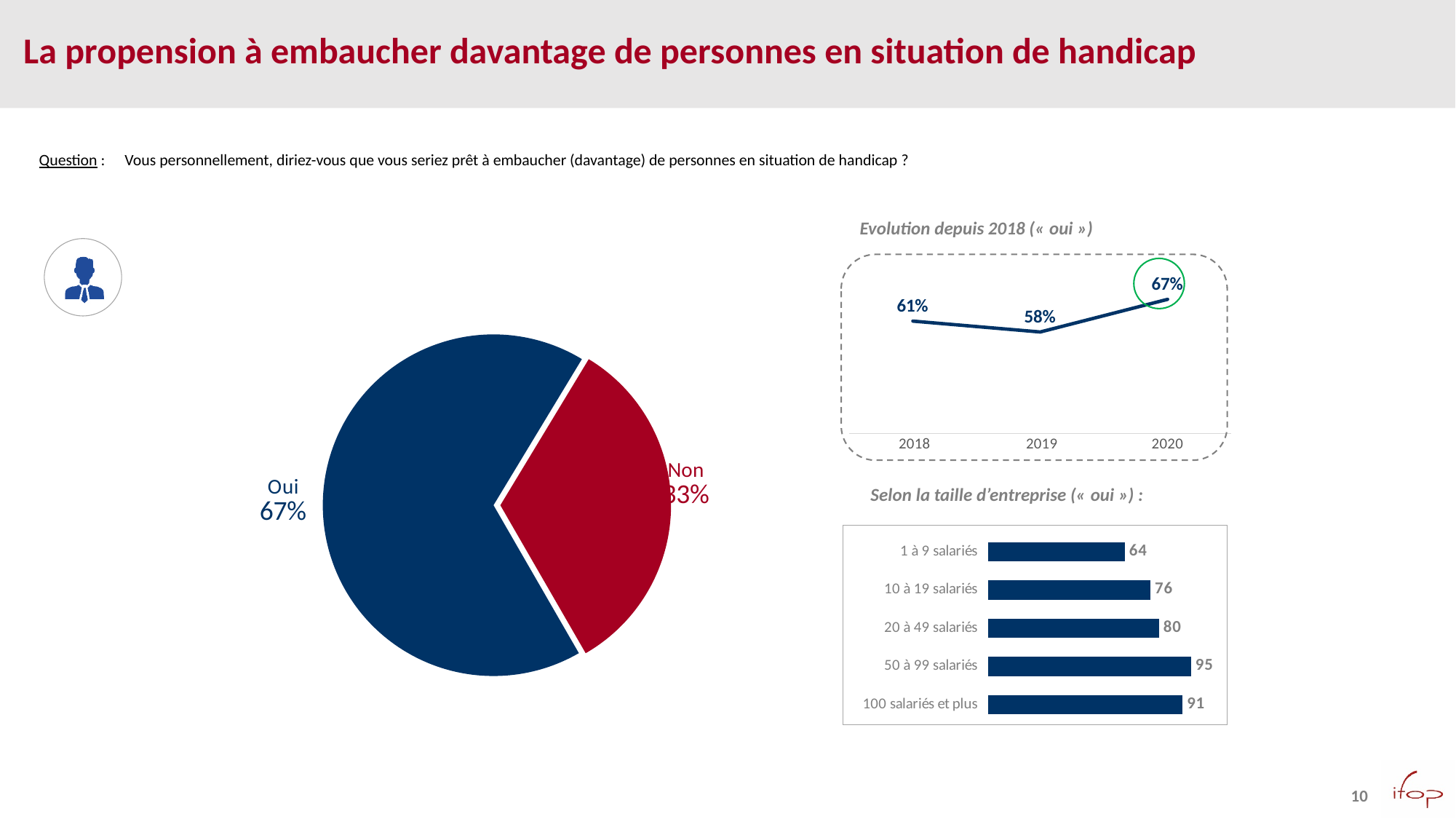
What kind of chart is the chart titled "Evolution depuis 2018 (« oui »)"? line chart In the chart titled "Evolution depuis 2018 (« oui »)", what is the value for 2018? 61% In the pie chart on the left, what share of respondents answered "Oui"? 67% In the chart titled "Selon la taille d'entreprise (« oui »)", which category has the lowest value? 1 à 9 salariés In the chart titled "Evolution depuis 2018 (« oui »)", what is the difference between the 2020 and 2019 values? 9 points In the chart titled "Selon la taille d'entreprise (« oui »)", what is the value for "20 à 49 salariés"? 80 In the chart titled "Evolution depuis 2018 (« oui »)", what is the value for 2019? 58% How many categories are shown in the chart titled "Selon la taille d'entreprise (« oui »)"? 5 What kind of chart is the chart on the left of the slide? pie chart In the chart titled "Selon la taille d'entreprise (« oui »)", which category has the highest value? 50 à 99 salariés In the pie chart on the left, which slice is larger, "Oui" or "Non"? Oui In the chart titled "Evolution depuis 2018 (« oui »)", which year has the highest value? 2020